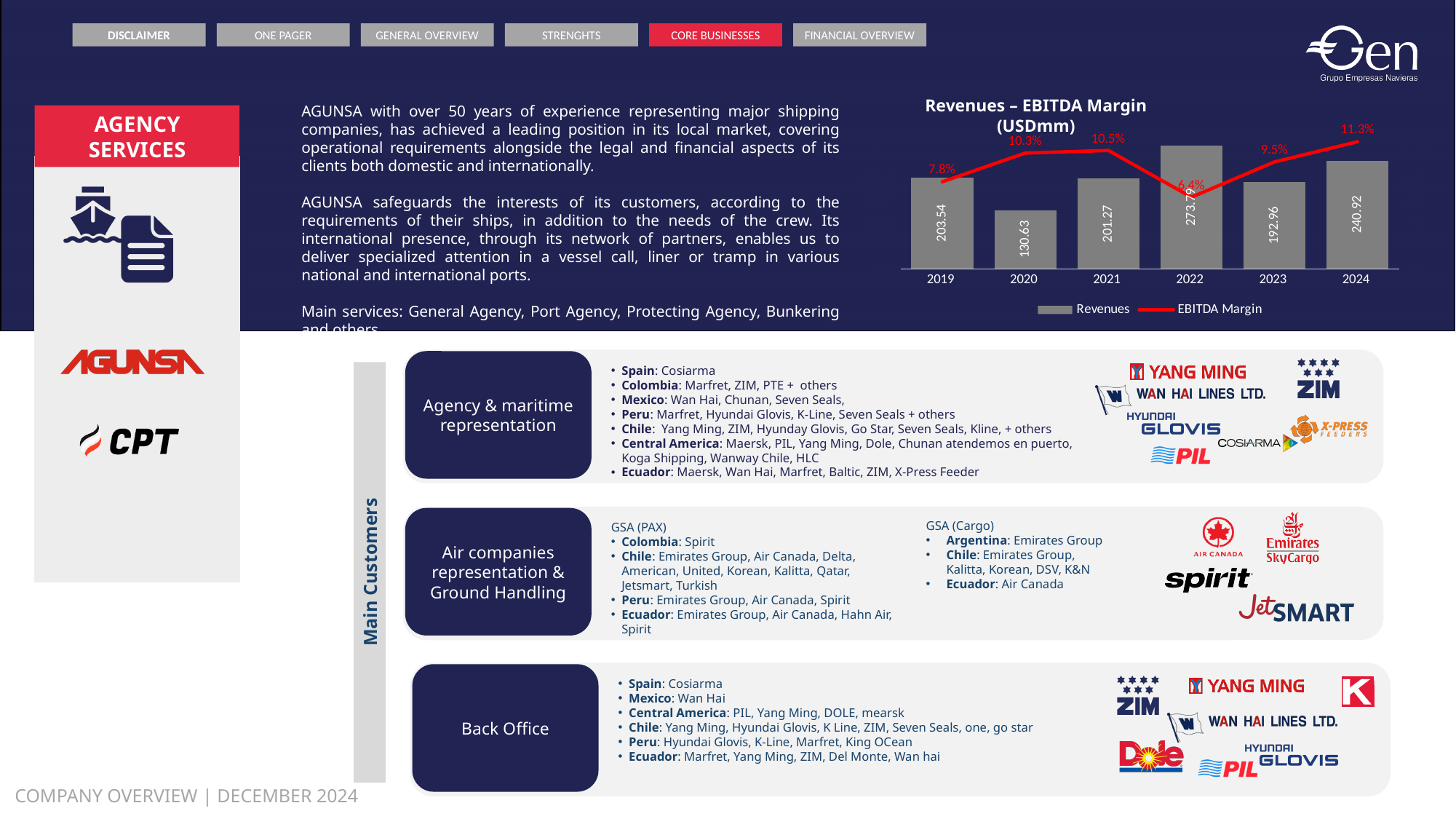
In the Revenues – EBITDA Margin chart, which year had the highest EBITDA margin? 2024 How many series does the legend of the Revenues – EBITDA Margin chart list? 2 How many years are shown on the x axis of the Revenues – EBITDA Margin chart? 6 In the Revenues – EBITDA Margin chart, what was the revenue in 2024? 240.92 In the Revenues – EBITDA Margin chart, which year had the highest revenue? 2022 In the Revenues – EBITDA Margin chart, what was the revenue in 2019? 203.54 In the Revenues – EBITDA Margin chart, what was the EBITDA margin in 2022? 6.4% In the Revenues – EBITDA Margin chart, what is the difference between the 2024 and 2019 revenues? 37.38 What kind of chart is the Revenues – EBITDA Margin chart? Combined bar and line chart In the Revenues – EBITDA Margin chart, what was the EBITDA margin in 2021? 10.5% In the Revenues – EBITDA Margin chart, which year had the lowest revenue? 2020 In the Revenues – EBITDA Margin chart, was revenue higher in 2021 or in 2023? 2021